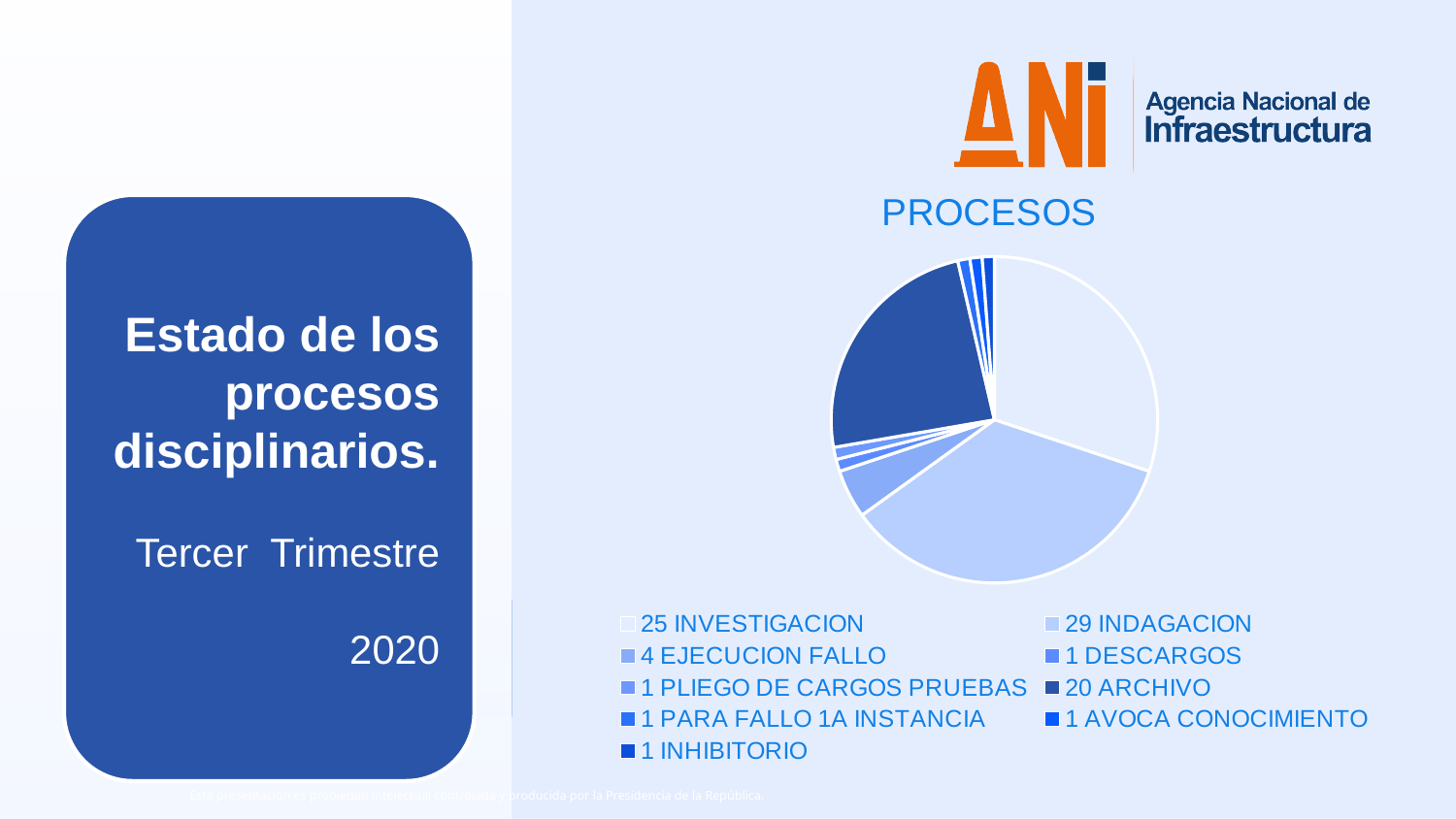
How many processes are in INDAGACION according to the legend? 29 What is the difference between the number of processes in INVESTIGACION and in ARCHIVO? 5 How many processes are in INVESTIGACION? 25 How many categories does the legend of the pie chart list? 9 What is the difference between the number of processes in INDAGACION and in INVESTIGACION? 4 How many processes are in EJECUCION FALLO? 4 Which has more processes, INVESTIGACION or ARCHIVO? INVESTIGACION What is the total number of processes across all categories in the pie chart? 83 How many processes are in ARCHIVO? 20 What is the title of the chart? PROCESOS What type of chart is shown under the title PROCESOS? pie chart Which category has the largest number of processes? INDAGACION